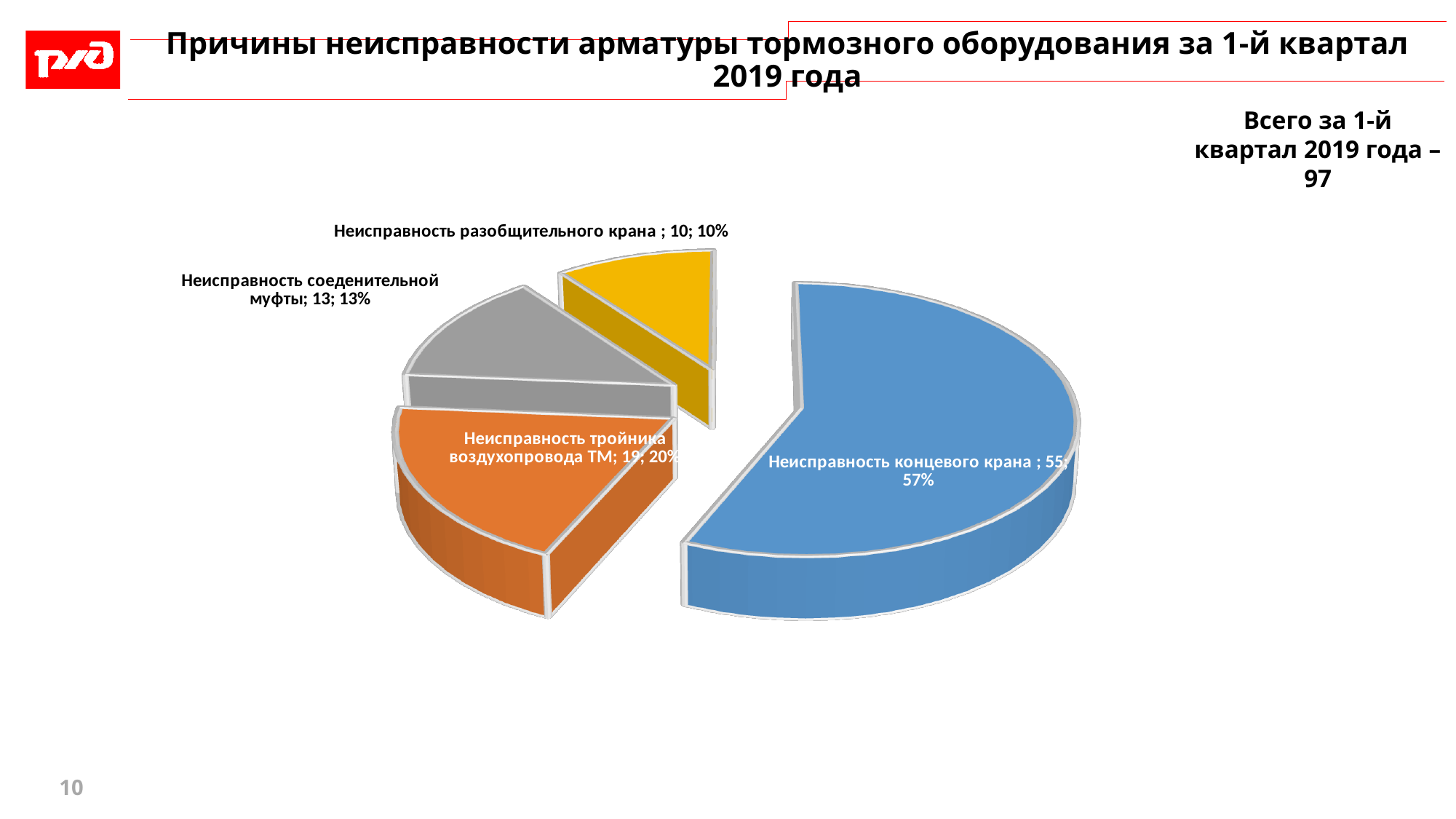
What total for the 1st quarter of 2019 is stated on the slide? 97 What kind of chart is shown on the slide? Pie chart How many slices does the pie chart have? 4 What share of the pie does "Неисправность концевого крана" take? 57% Which category has the largest slice of the pie? Неисправность концевого крана What is the value for "Неисправность концевого крана"? 55 What is the value for "Неисправность тройника воздухопровода ТМ"? 19 What is the value for "Неисправность разобщительного крана"? 10 What percentage is shown for "Неисправность соеденительной муфты"? 13% What is the difference between the values for "Неисправность концевого крана" and "Неисправность тройника воздухопровода ТМ"? 36 Which category has the smallest slice of the pie? Неисправность разобщительного крана Which is larger: the value for "Неисправность соеденительной муфты" or for "Неисправность разобщительного крана"? Неисправность соеденительной муфты